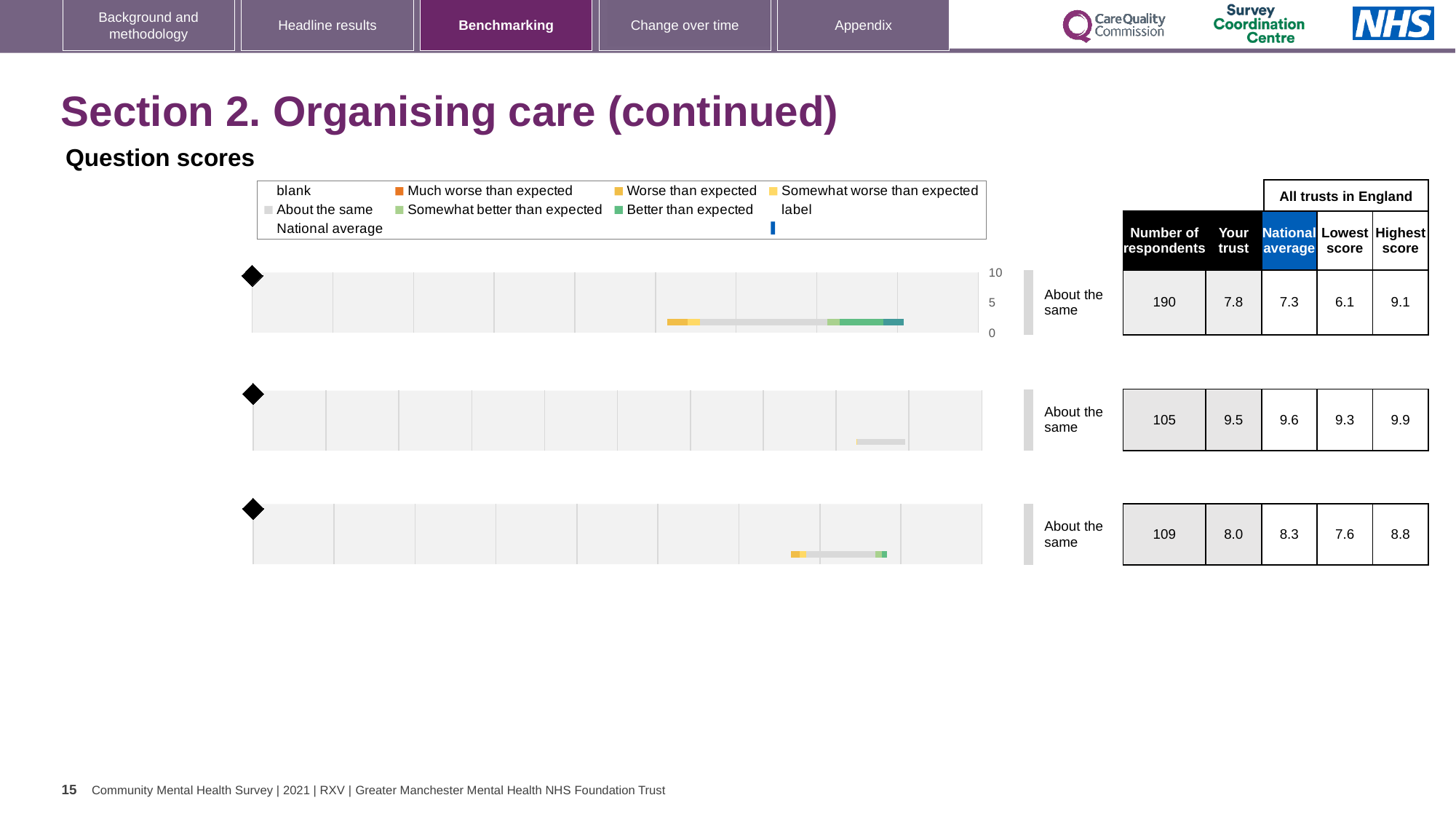
What benchmark label is shown to the right of the bottom chart? About the same Which chart row has the lowest number of respondents? the middle row How many benchmarking chart rows are shown on the slide? 3 For the middle chart row, what is the difference between the Highest score and the Lowest score? 0.6 Which chart row has the highest 'Your trust' score? the middle row What kind of chart is used for the three benchmarking rows on this slide? bar chart In the table next to the middle chart, what is the National average score? 9.6 In the table next to the bottom chart, what is the number of respondents? 109 In the legend, what colour represents 'Much worse than expected'? orange In the table next to the top chart, what is the 'Your trust' score? 7.8 For the top chart row, which is larger: the 'Your trust' score or the National average? Your trust